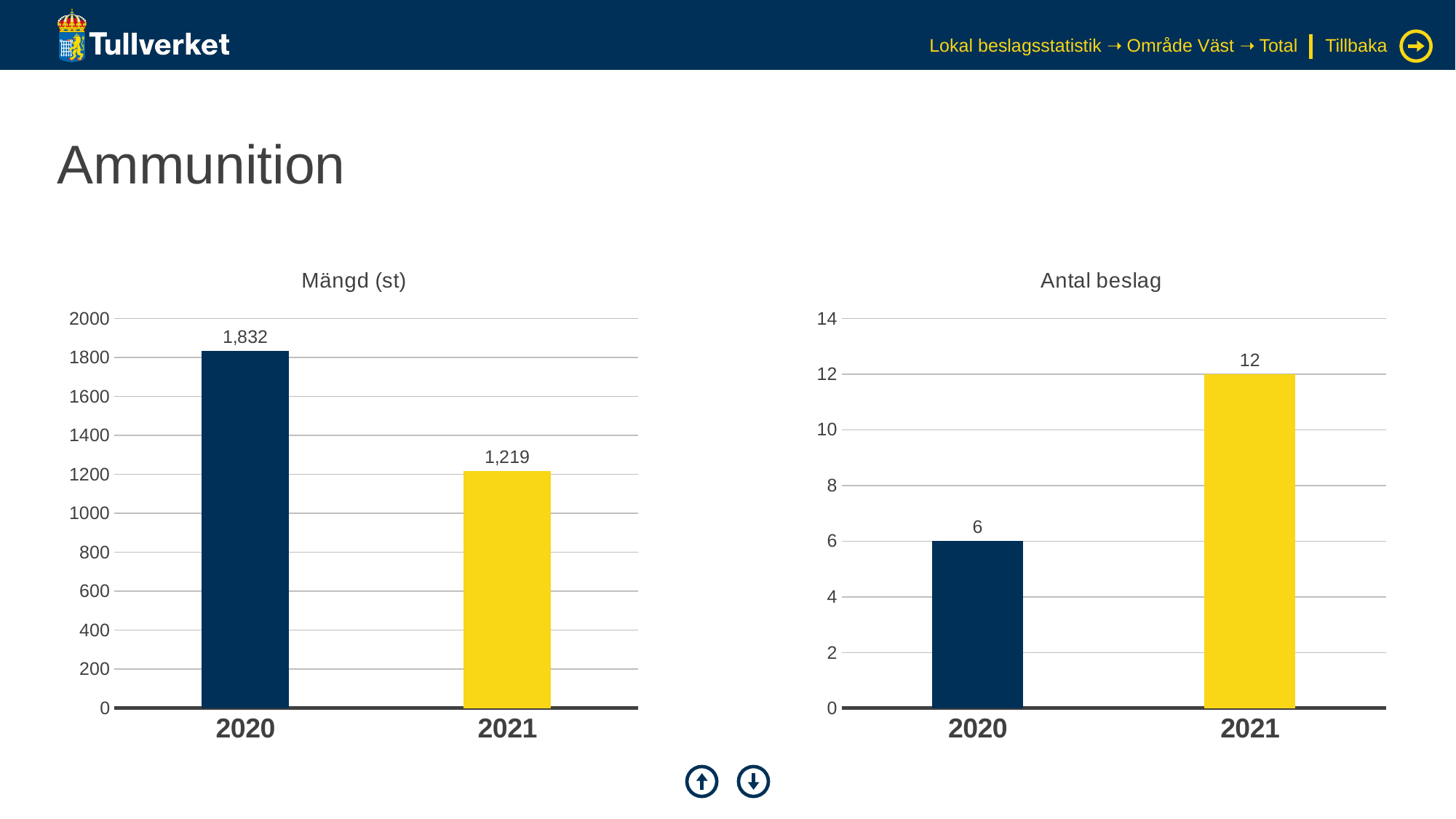
In the 'Antal beslag' chart, what is the value for 2021? 12 How many categories are shown in the 'Antal beslag' chart? 2 In the 'Mängd (st)' chart, do the values rise or fall from 2020 to 2021? Fall What kind of chart is the 'Mängd (st)' chart? Bar chart In the 'Mängd (st)' chart, what is the difference between the 2020 and 2021 values? 613 In the 'Mängd (st)' chart, what is the value for 2021? 1,219 In the 'Mängd (st)' chart, what is the value for 2020? 1,832 In the 'Antal beslag' chart, what is the value for 2020? 6 In the 'Antal beslag' chart, what is the difference between the 2021 and 2020 values? 6 In the 'Mängd (st)' chart, which year has the highest value? 2020 In the 'Antal beslag' chart, which year has the lowest value? 2020 In the 'Antal beslag' chart, is the value for 2021 larger than the value for 2020? Yes